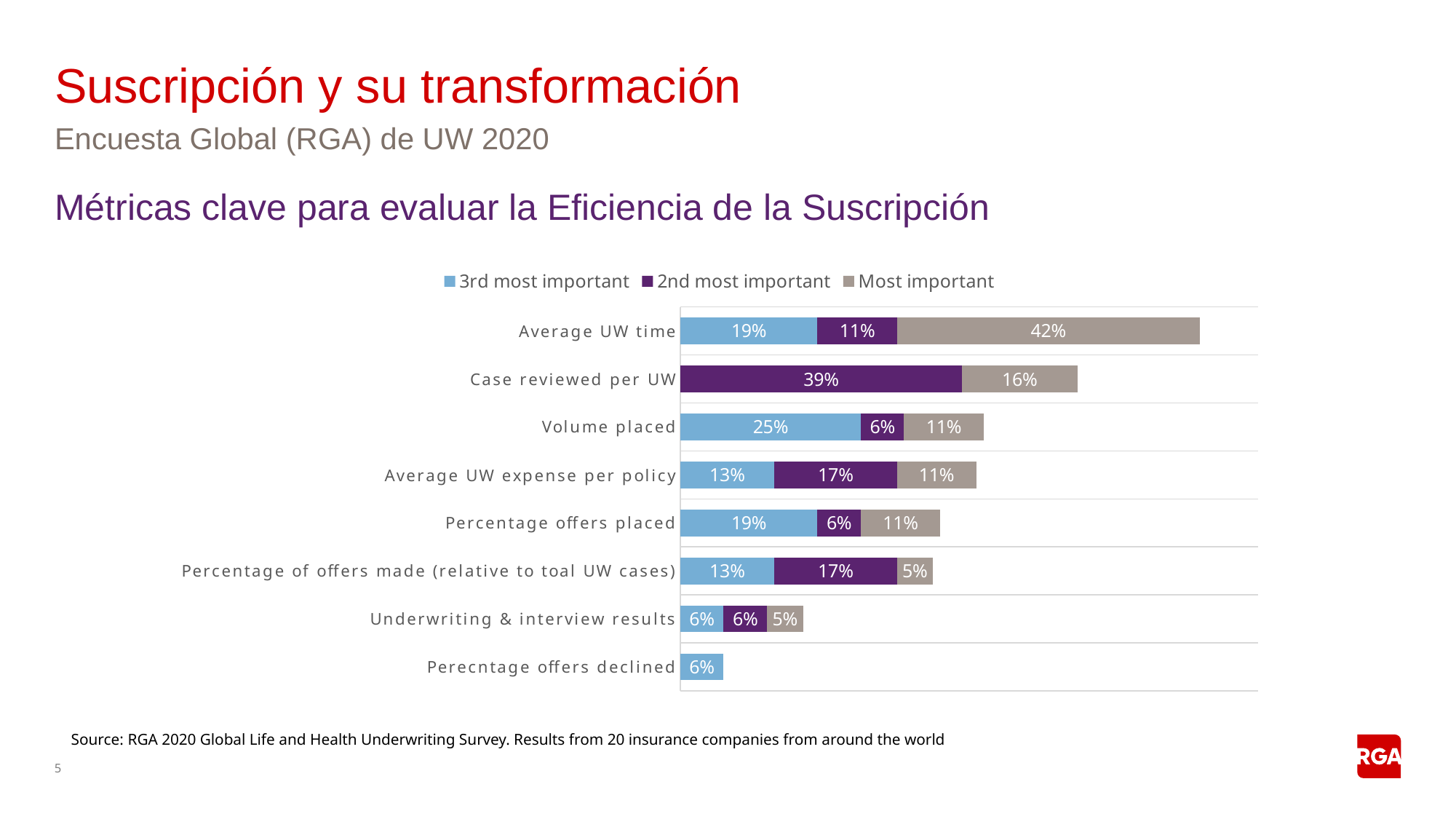
How many series does the legend list? 3 What is the '2nd most important' value for Case reviewed per UW? 39% Which category has the highest 'Most important' value? Average UW time Which category has the shortest total bar? Perecntage offers declined What kind of chart is shown on the slide? Stacked bar chart Which is larger: the '2nd most important' value for Average UW expense per policy or for Percentage offers placed? Average UW expense per policy What is the difference between the 'Most important' values for Average UW time and Case reviewed per UW? 26% What is the 'Most important' value for Average UW time? 42% How many categories are plotted on the chart? 8 What is the total of the stacked bar for Average UW time? 72% What is the '3rd most important' value for Volume placed? 25% Which legend entry is shown in purple? 2nd most important